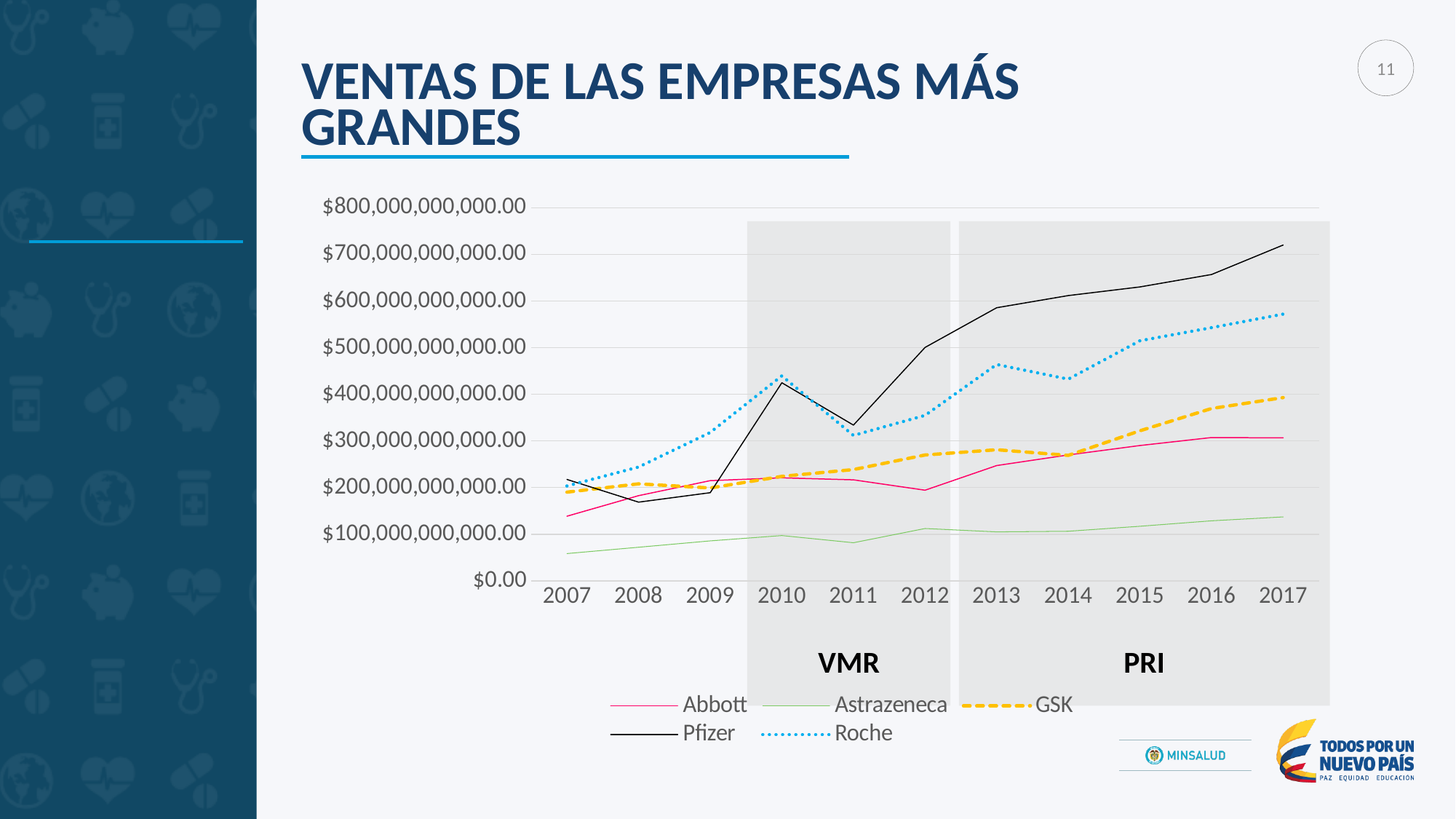
How many years are shown along the x axis? 11 Does the Pfizer line rise or fall from 2012 to 2017? rises How many series does the legend list? 5 Is the value for Pfizer in 2008 greater or less than $200,000,000,000.00? less Is the value for GSK in 2017 greater or less than $300,000,000,000.00? greater Is the value for Roche in 2017 greater or less than $600,000,000,000.00? less In 2009, which is larger: the value for Pfizer or the value for Roche? Roche Which series has the highest value in 2017? Pfizer What kind of chart is shown on the slide? line chart In 2017, which is larger: the value for Pfizer or the value for Roche? Pfizer What are the labels of the two shaded regions on the chart? VMR and PRI